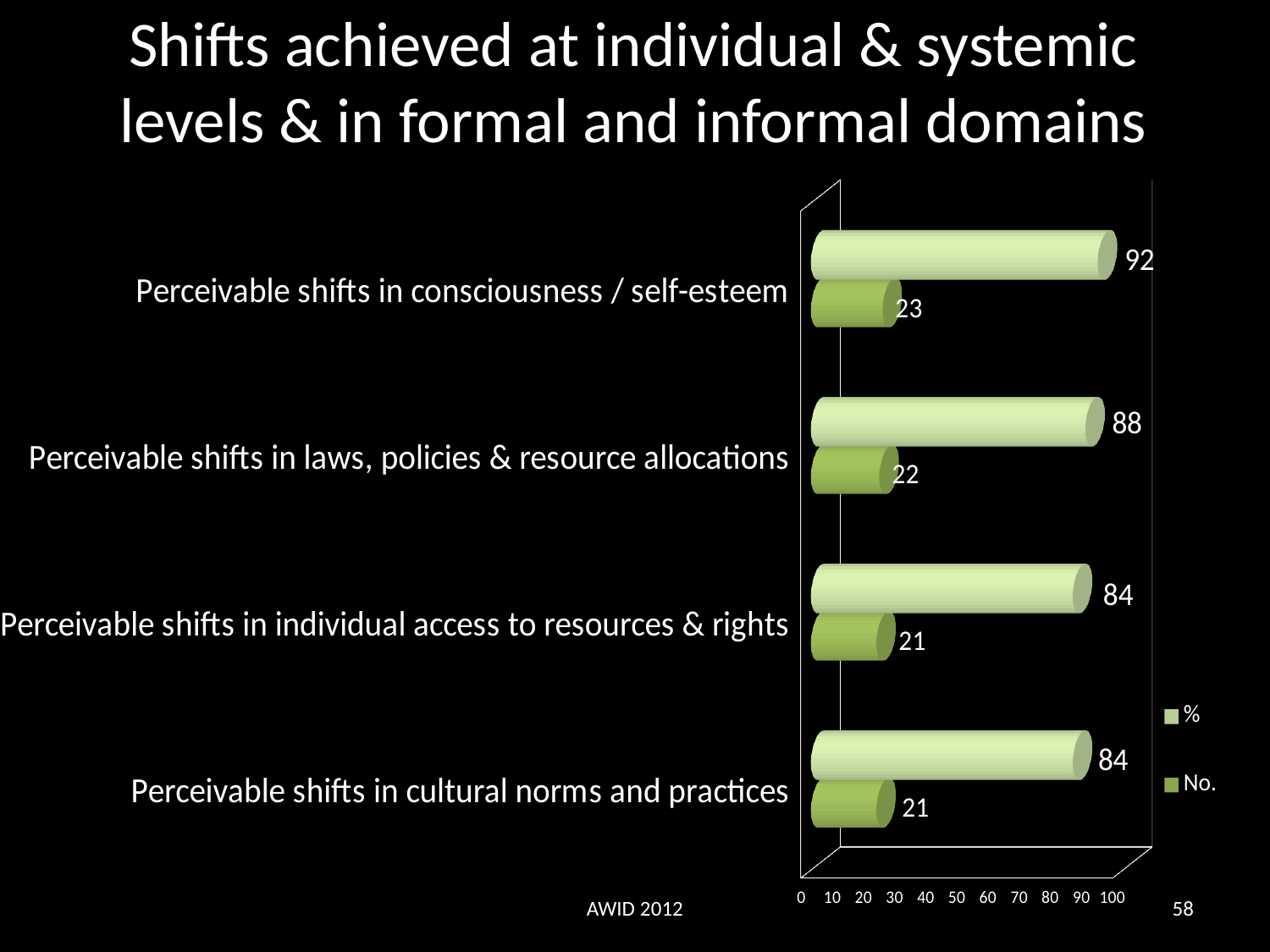
What is the No. value for 'Perceivable shifts in laws, policies & resource allocations'? 22 What is the % value for 'Perceivable shifts in consciousness / self-esteem'? 92 What is the No. value for 'Perceivable shifts in individual access to resources & rights'? 21 Which is larger: the No. value for 'Perceivable shifts in consciousness / self-esteem' or the No. value for 'Perceivable shifts in cultural norms and practices'? Perceivable shifts in consciousness / self-esteem What is the % value for 'Perceivable shifts in cultural norms and practices'? 84 How many series does the legend list? 2 What are the two series named in the legend? % and No. Is the % value for 'Perceivable shifts in individual access to resources & rights' greater or less than 50? greater How many categories are shown on the chart? 4 Which category has the highest % value? Perceivable shifts in consciousness / self-esteem What kind of chart is shown on the slide? bar chart What is the difference between the % values for 'Perceivable shifts in consciousness / self-esteem' and 'Perceivable shifts in laws, policies & resource allocations'? 4